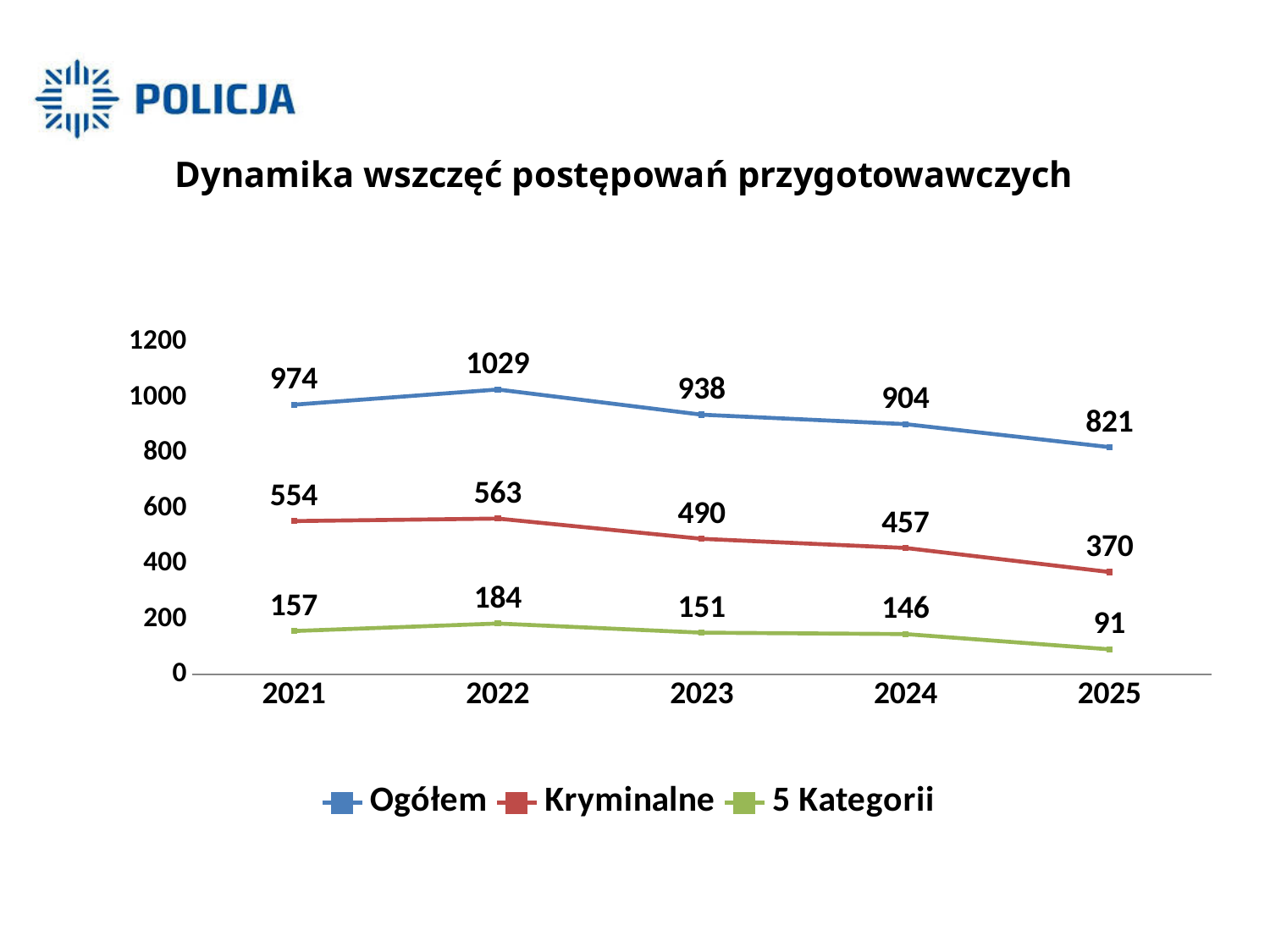
What is the value for 5 Kategorii in 2025? 91 In which year is the Ogółem series highest? 2022 Which is larger: the 5 Kategorii value in 2022 or in 2023? 2022 In which year is the Kryminalne series lowest? 2025 How many series does the legend list? 3 What is the value for Kryminalne in 2024? 457 Does the Ogółem series rise or fall from 2022 to 2025? fall What kind of chart is shown? line chart What is the value for Ogółem in 2022? 1029 Is the Kryminalne value for 2023 greater or less than 400? greater How many years are shown on the x axis? 5 What is the difference between the Ogółem value in 2021 and in 2025? 153